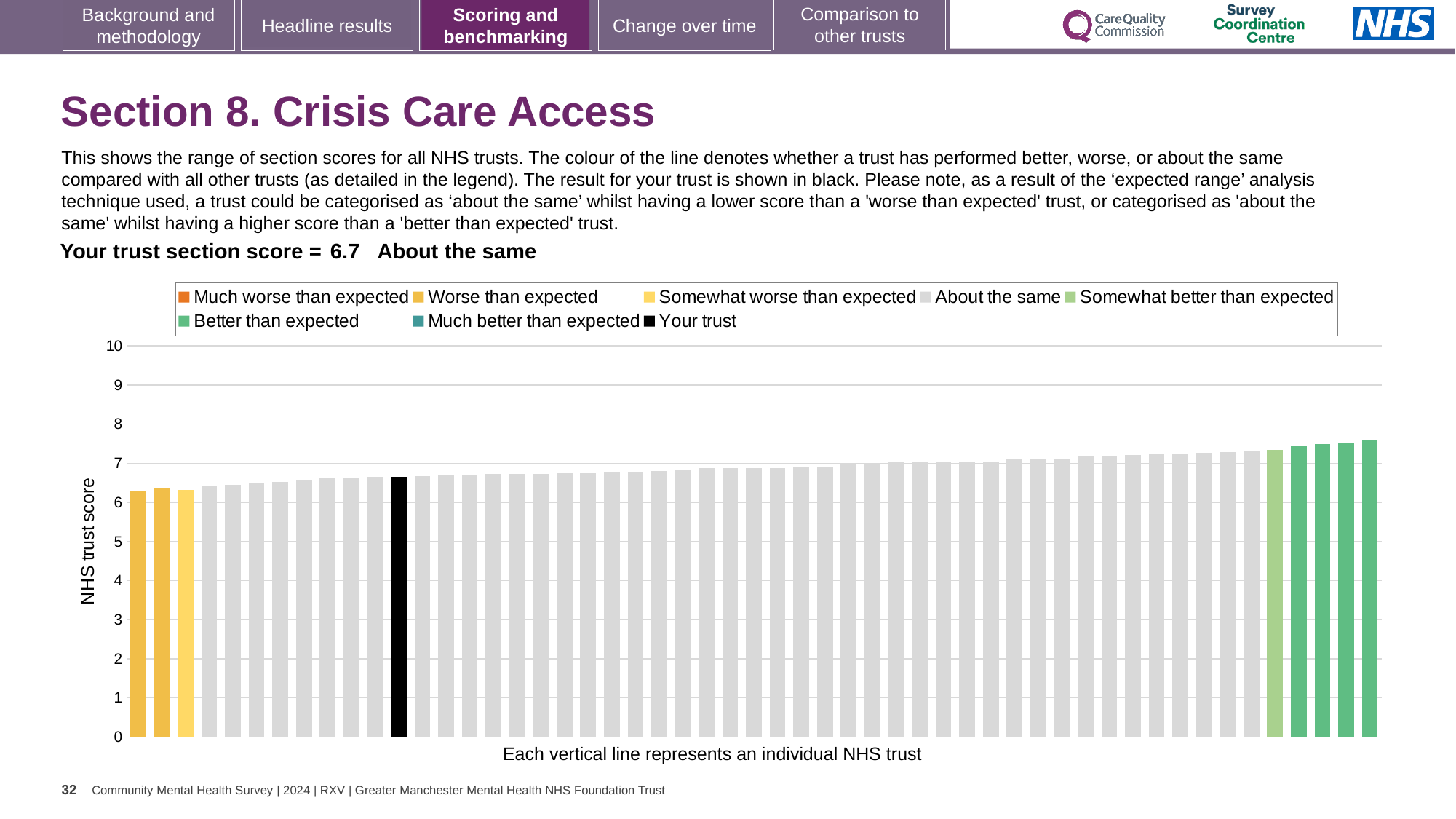
What is the section score for your trust? 6.7 Do the bar values rise or fall from left to right along the x axis? rise How many entries does the chart legend list? 8 How many bars are coloured as 'Better than expected' (green)? 4 How many bars are coloured as 'Worse than expected' (yellow)? 2 Is the tallest bar on the chart greater or less than 7? greater Is the tallest bar on the chart greater or less than 8? less Is the shortest bar on the chart greater or less than 7? less What is the label on the vertical axis? NHS trust score Which performance category is your trust placed in? About the same What type of chart is shown on the slide? bar chart